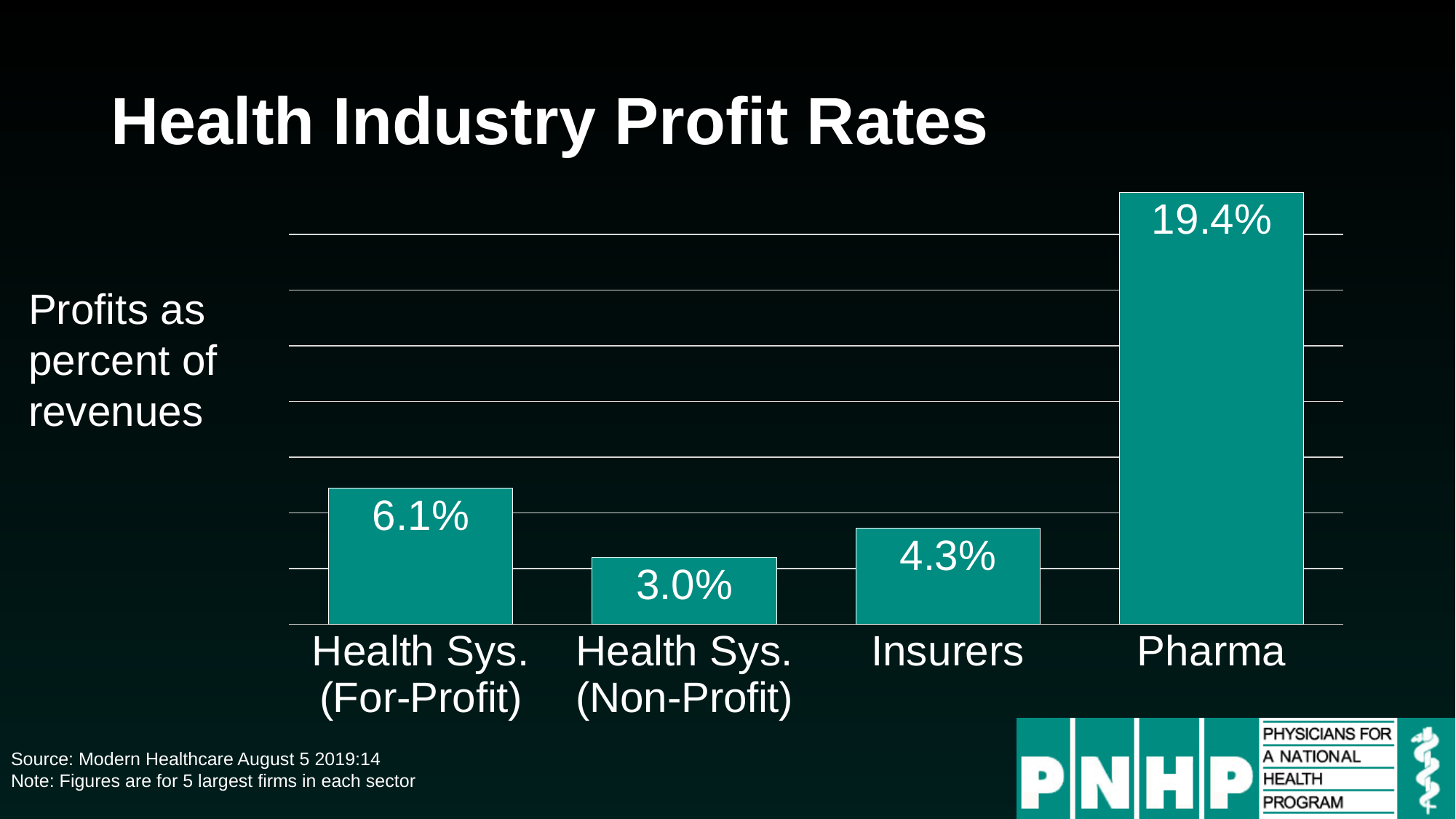
How many sectors are shown in the chart? 4 Which has a higher profit rate, Insurers or Health Sys. (For-Profit)? Health Sys. (For-Profit) Which sector has the highest profit rate? Pharma What is the profit rate for Insurers? 4.3% What is the title of the chart on the slide? Health Industry Profit Rates What is the profit rate for Health Sys. (For-Profit)? 6.1% What kind of chart is shown on the slide? Bar chart What is the profit rate for Health Sys. (Non-Profit)? 3.0% What is the difference in profit rate between Pharma and Insurers? 15.1% Which sector has the lowest profit rate? Health Sys. (Non-Profit) What is the profit rate for Pharma? 19.4% What is the difference in profit rate between Health Sys. (For-Profit) and Health Sys. (Non-Profit)? 3.1%